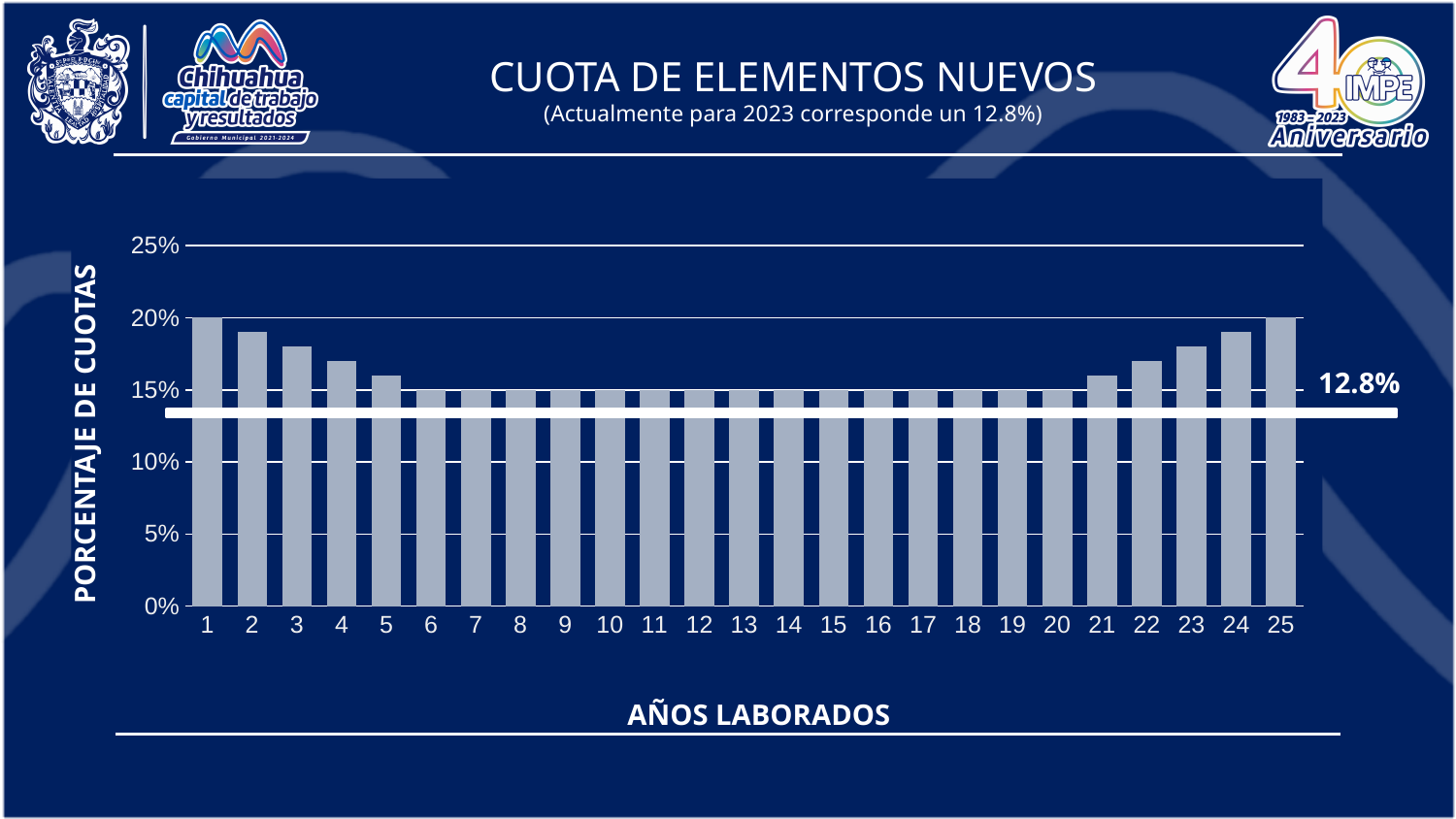
How many years (categories) are shown on the x axis of the chart? 25 What percentage is labelled on the horizontal line drawn across the chart? 12.8% Which is larger, the value for year 1 or the value for year 15? year 1 Is the value for year 5 greater or less than 20%? less What kind of chart is shown on the slide? bar chart What is the difference between the value for year 1 and the value for year 10? 5% What is the value for year 25 on the chart? 20% Which is larger, the value for year 12 or the value for year 23? year 23 Do the values rise or fall from year 1 to year 6? fall Is the value for year 3 greater or less than 15%? greater What is the value for year 10 on the chart? 15% What is the value for year 1 on the chart? 20%